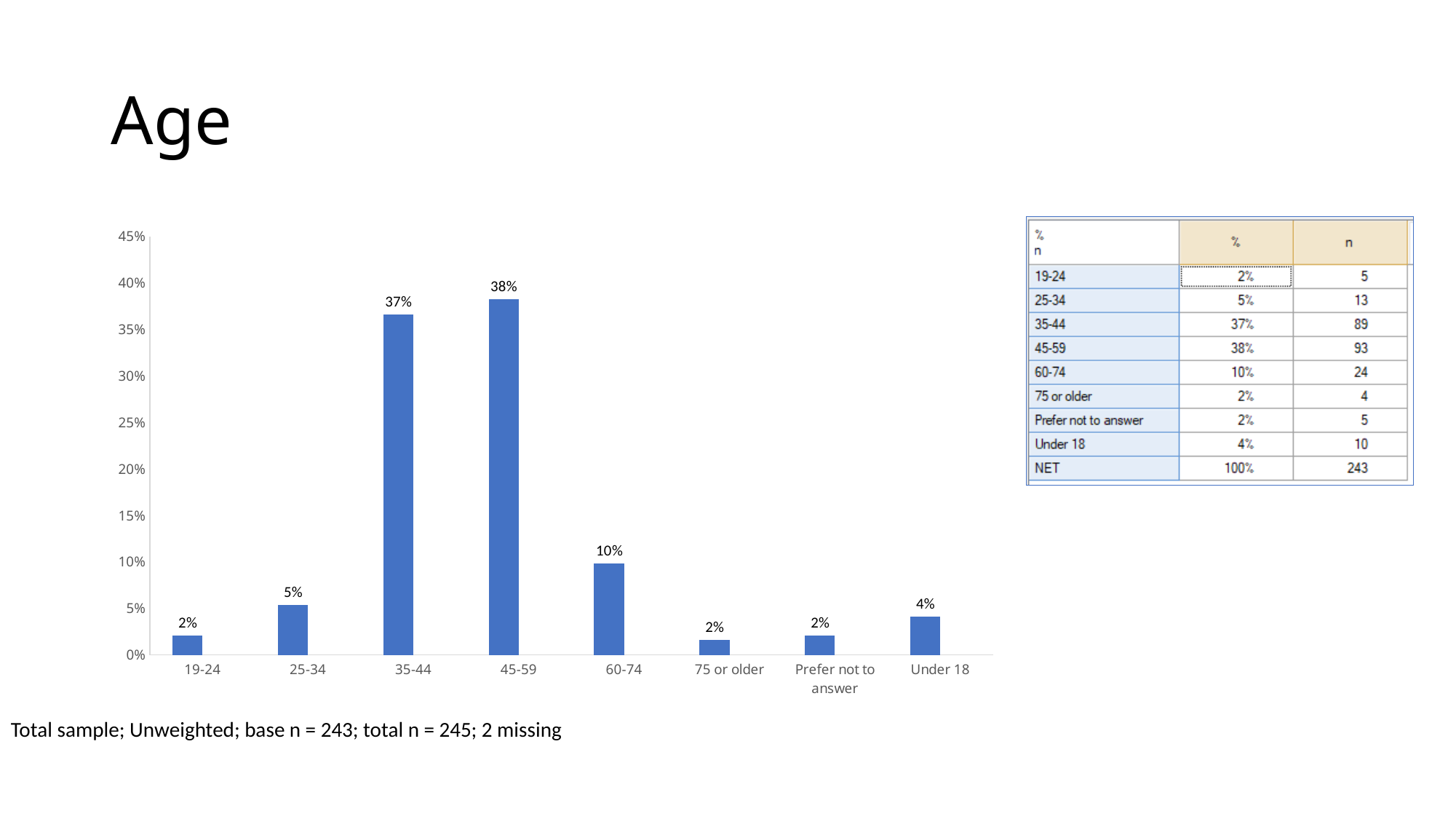
What kind of chart is shown on the slide? bar chart What is the difference between the values for 45-59 and 60-74? 28% What is the difference between the values for 25-34 and Under 18? 1% Which age category has the highest value? 45-59 What is the title of the slide? Age Is the value for 35-44 greater or less than 35%? greater How many categories are shown on the x axis? 8 What is the value for the 60-74 age group? 10% Which is larger, the value for 25-34 or the value for 60-74? 60-74 What is the value for Under 18? 4% What is the value for the 35-44 age group? 37% What is the highest value shown on the y axis? 45%